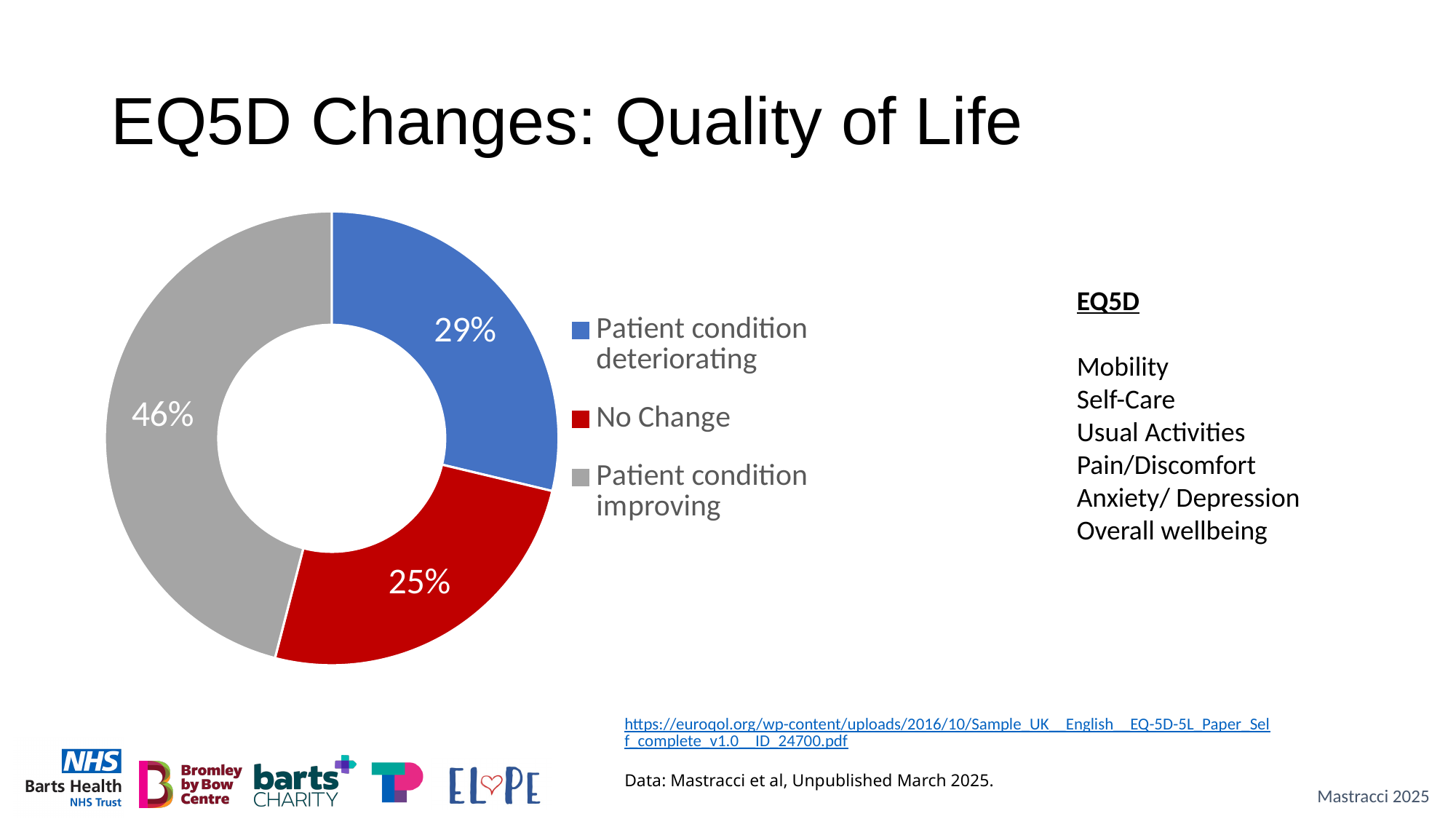
What is the combined share of patients whose condition was deteriorating or showed no change? 54% Which is larger: the share for patient condition deteriorating or the share for no change? Patient condition deteriorating What colour represents the No Change category? Red What is the title of the slide containing the chart? EQ5D Changes: Quality of Life What percentage of patients had their condition improving? 46% What kind of chart is shown on the slide? Doughnut (pie) chart What percentage of patients had their condition deteriorating? 29% What percentage of patients showed no change? 25% Which category has the largest share of the chart? Patient condition improving How many categories does the chart show? 3 What is the difference in percentage points between patients improving and patients deteriorating? 17 Which category has the smallest share of the chart? No Change